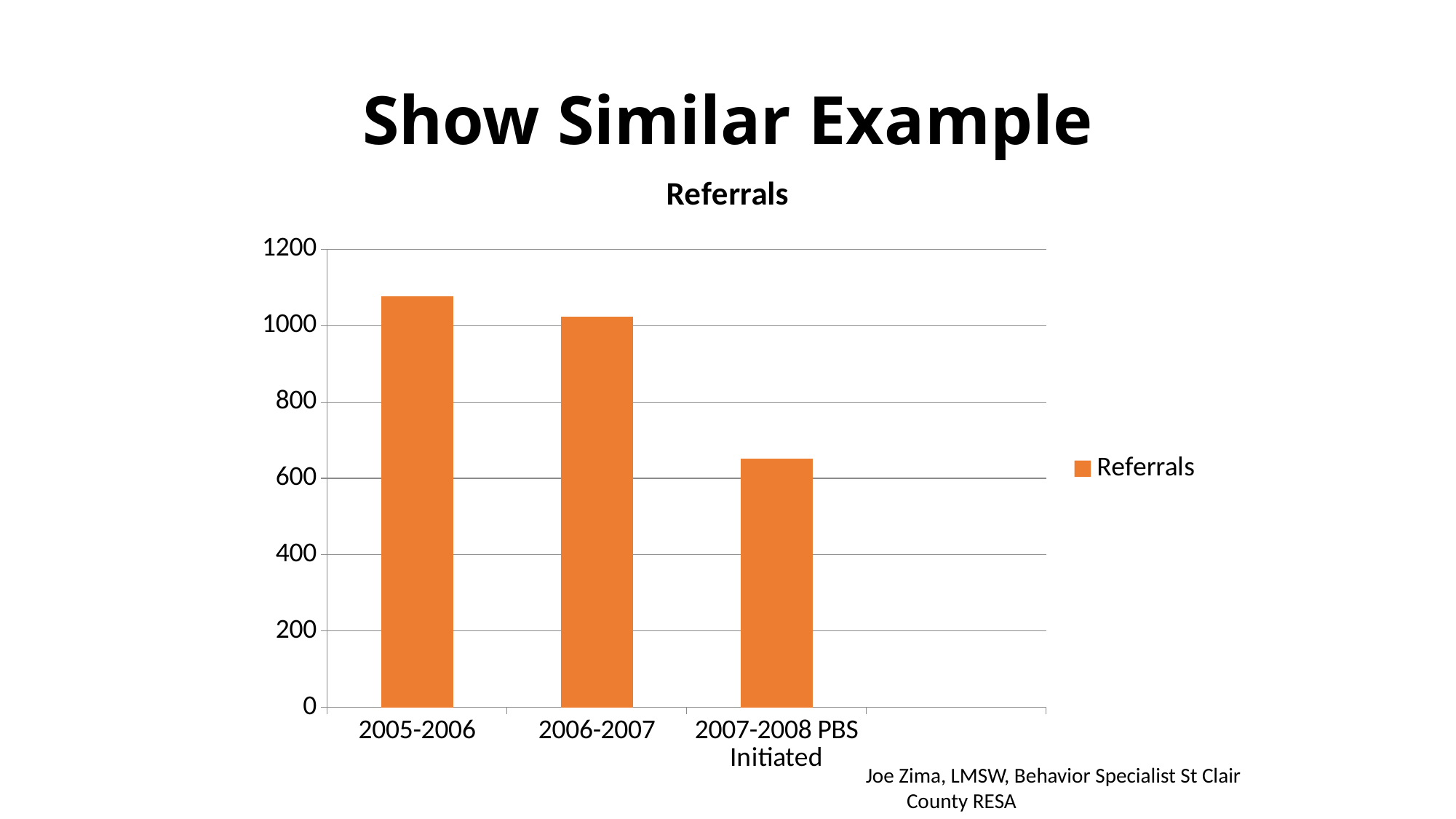
What colour are the bars in the chart? orange What is the title of the chart? Referrals Which category has the highest number of referrals? 2005-2006 How many series does the legend list? 1 Which is larger, the value for 2006-2007 or the value for 2007-2008 PBS Initiated? 2006-2007 Is the value for 2005-2006 greater or less than 1000? greater Do the referral values rise or fall from left to right along the x axis? fall Is the value for 2007-2008 PBS Initiated greater or less than 800? less Which category has the lowest number of referrals? 2007-2008 PBS Initiated How many categories are shown on the x axis of the chart? 3 What kind of chart is shown on the slide? bar chart